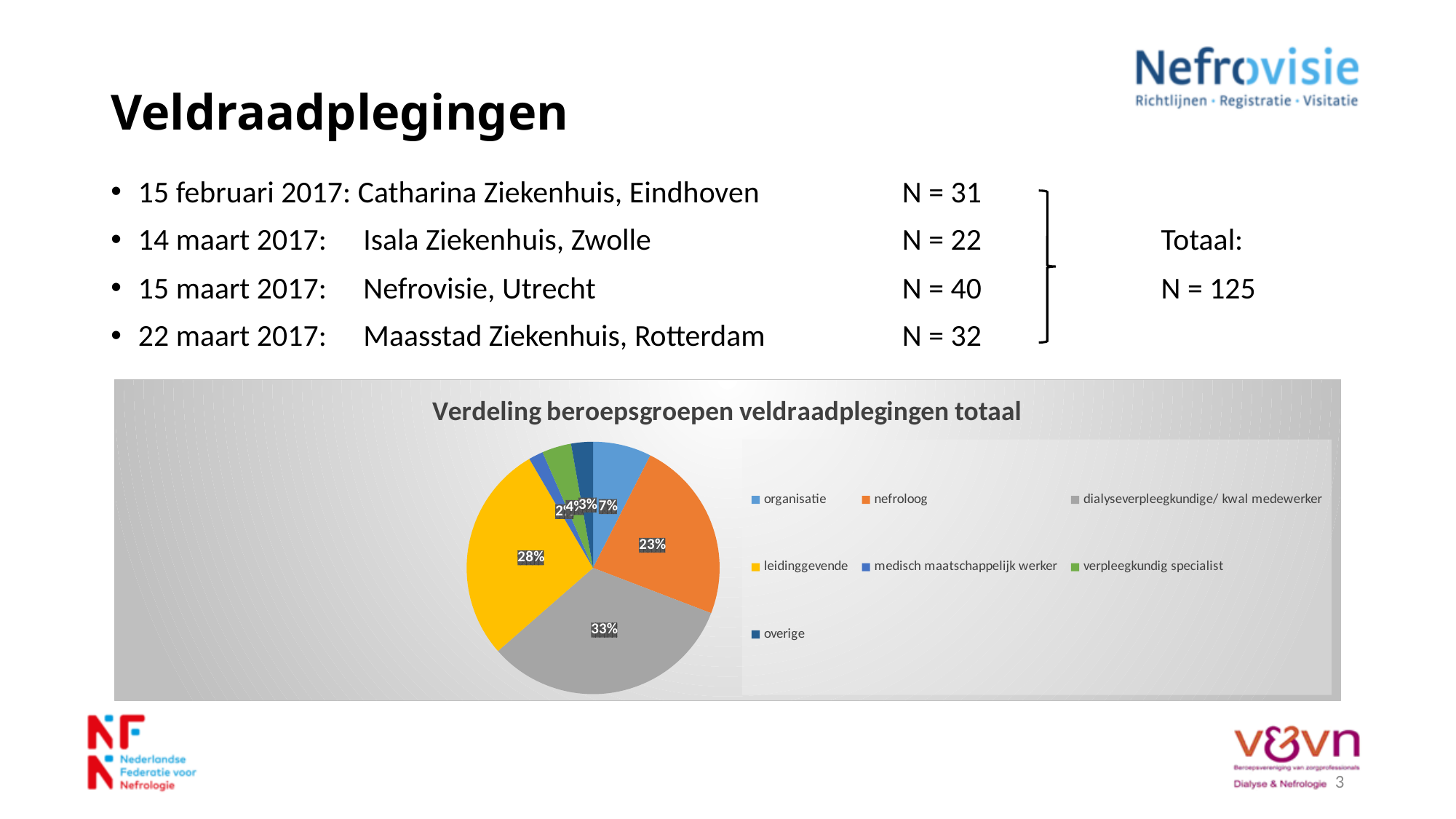
Which category has the largest share of the pie? dialyseverpleegkundige/ kwal medewerker What is the title of the chart? Verdeling beroepsgroepen veldraadplegingen totaal What percentage of the pie is dialyseverpleegkundige/ kwal medewerker? 33% What percentage of the pie is nefroloog? 23% What percentage of the pie is organisatie? 7% What percentage of the pie is leidinggevende? 28% What kind of chart is shown on the slide? pie chart Which is larger, the share for leidinggevende or the share for nefroloog? leidinggevende What colour is the leidinggevende slice? yellow What is the difference between the share for dialyseverpleegkundige/ kwal medewerker and the share for leidinggevende? 5% How many categories does the legend list? 7 What percentage of the pie is verpleegkundig specialist? 4%